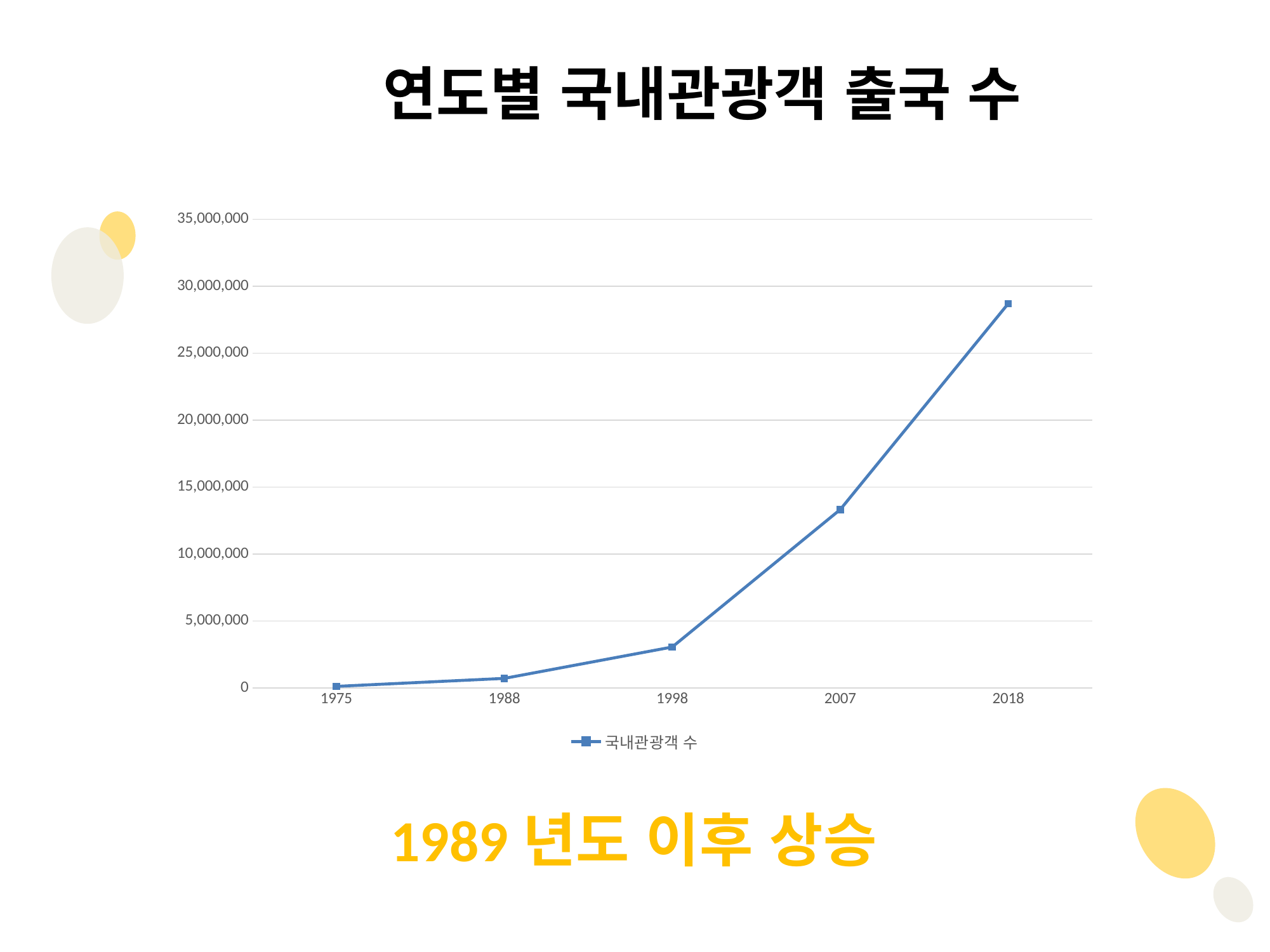
What is the title of the chart? 연도별 국내관광객 출국 수 How many years are plotted on the x axis of the chart? 5 How many series does the chart's legend list? 1 Do the values rise or fall from 1975 to 2018? rise Which year has the highest value in the chart? 2018 Which year has the larger value, 2007 or 1998? 2007 What is the name of the series shown in the legend? 국내관광객 수 Is the value for 2007 greater or less than 15,000,000? less Is the value for 1998 greater or less than 5,000,000? less Which year has the lowest value in the chart? 1975 What kind of chart is shown on the slide? line chart Is the value for 2018 greater or less than 25,000,000? greater